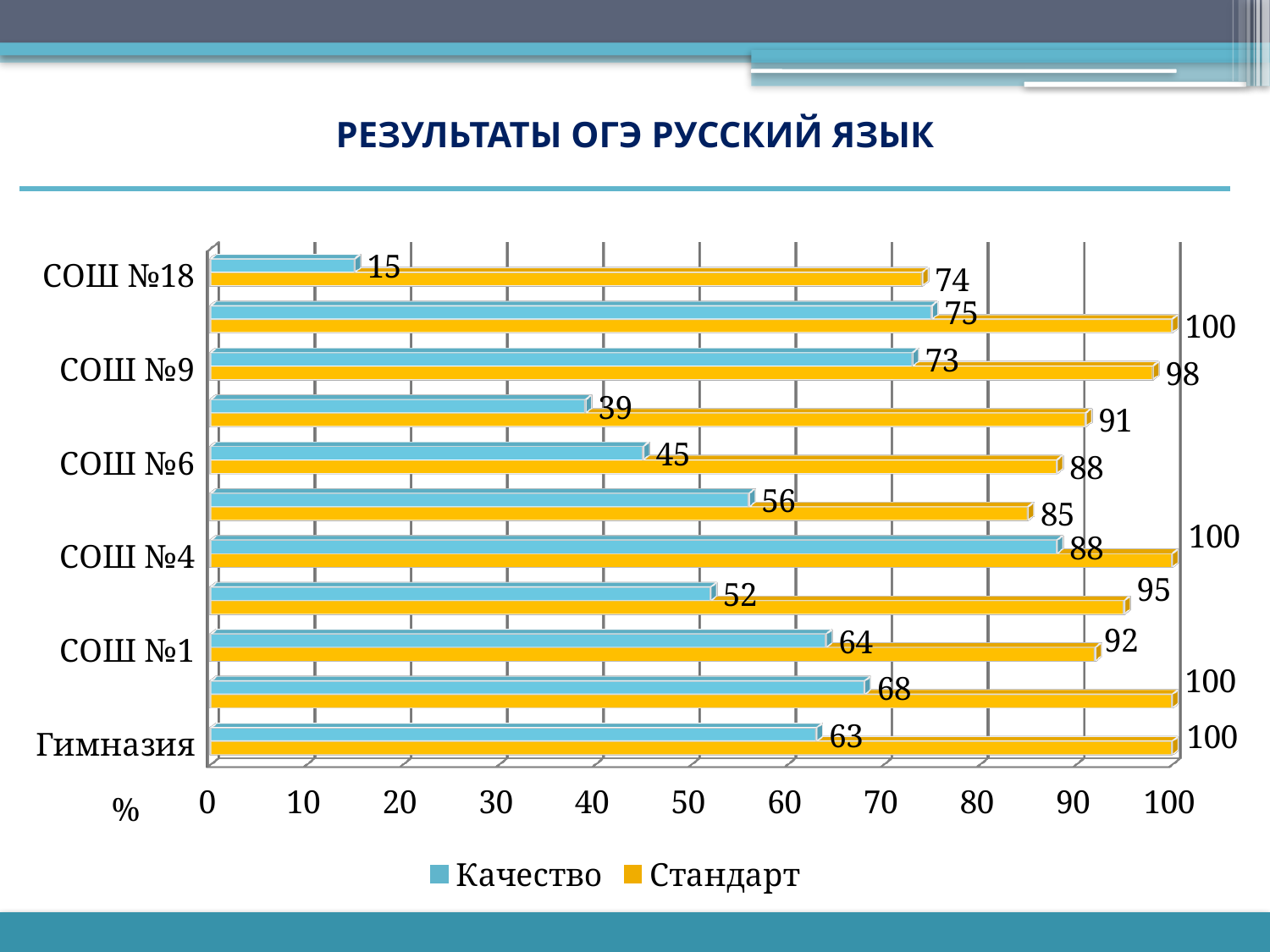
What is the Качество value for СОШ №6? 45 What is the Стандарт value for Гимназия? 100 How many series does the legend list? 2 Which school has the lowest Стандарт value? СОШ №18 What is the Стандарт value for СОШ №9? 98 What is the Качество value for СОШ №18? 15 Which colour represents the Стандарт series? Orange Which is larger, the Качество value for СОШ №9 or for Гимназия? СОШ №9 Which school has the highest Качество value? СОШ №4 What kind of chart is shown on the slide? Bar chart What is the title of the slide? РЕЗУЛЬТАТЫ ОГЭ РУССКИЙ ЯЗЫК What is the difference between the Стандарт and Качество values for СОШ №1? 28